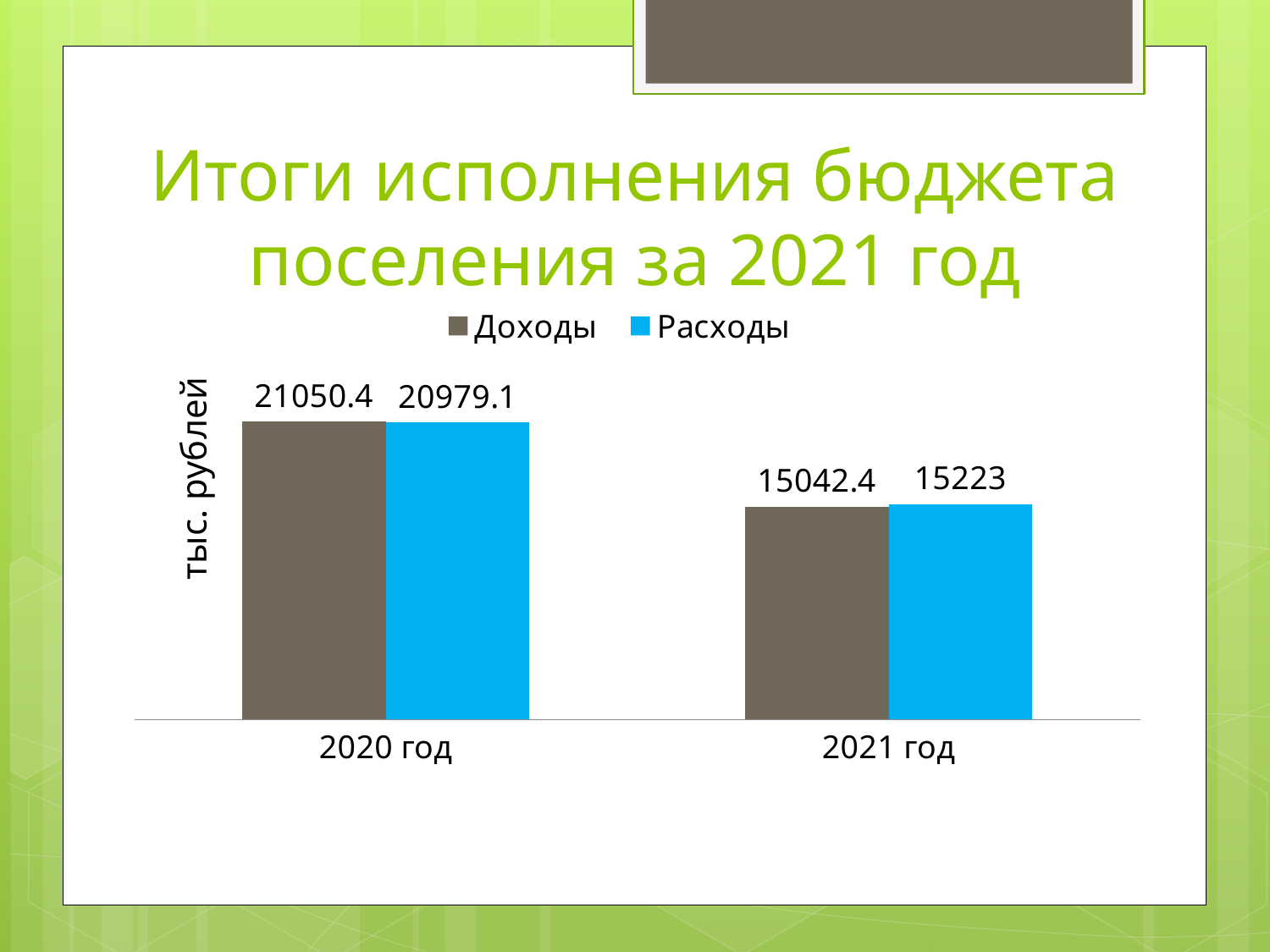
For 2021 год, which is larger: Доходы or Расходы? Расходы What is the difference between Расходы and Доходы for 2021 год? 180.6 What is the value of Расходы for 2021 год? 15223 What kind of chart is shown on the slide? Bar chart What is the value of Доходы for 2020 год? 21050.4 What is the value of Расходы for 2020 год? 20979.1 What is the difference between Доходы for 2020 год and Доходы for 2021 год? 6008 Which year has the higher value for Доходы? 2020 год Which bar shows the lowest value on the chart? Доходы, 2021 год How many series does the legend list? 2 What is the label on the vertical axis of the chart? тыс. рублей What is the value of Доходы for 2021 год? 15042.4